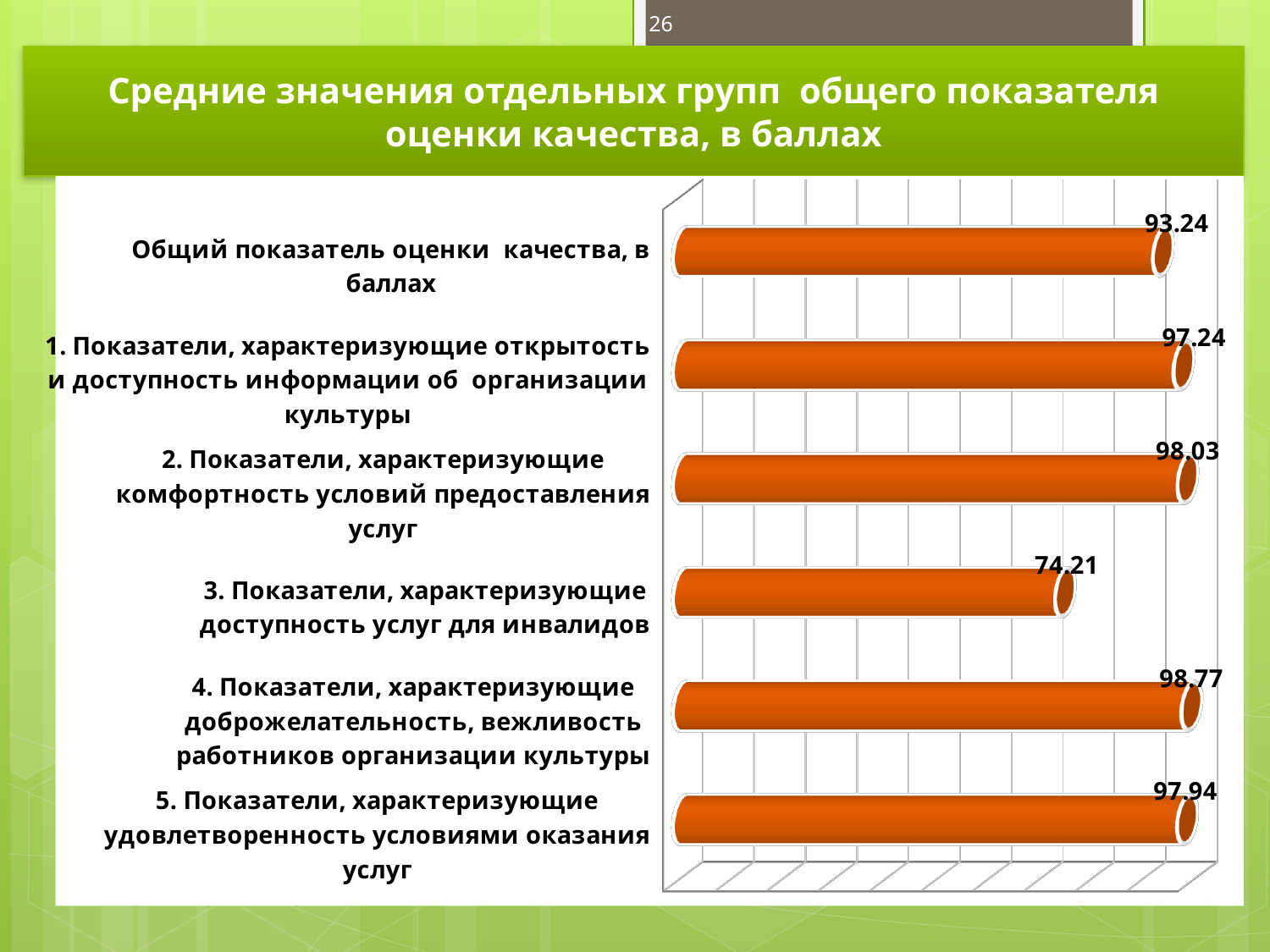
How many categories are shown in the chart? 6 What is the value for "2. Показатели, характеризующие комфортность условий предоставления услуг"? 98.03 What is the value for "4. Показатели, характеризующие доброжелательность, вежливость работников организации культуры"? 98.77 What is the difference between the values for "1. Показатели, характеризующие открытость и доступность информации об организации культуры" and "Общий показатель оценки качества, в баллах"? 4.00 What is the value for "3. Показатели, характеризующие доступность услуг для инвалидов"? 74.21 What kind of chart is shown on the slide? Bar chart What is the difference between the values for "4. Показатели, характеризующие доброжелательность, вежливость работников организации культуры" and "3. Показатели, характеризующие доступность услуг для инвалидов"? 24.56 What is the value for "Общий показатель оценки качества, в баллах"? 93.24 What is the title of the slide containing the chart? Средние значения отдельных групп общего показателя оценки качества, в баллах Which category has the lowest value? 3. Показатели, характеризующие доступность услуг для инвалидов Which category has the highest value? 4. Показатели, характеризующие доброжелательность, вежливость работников организации культуры Which is larger: the value for "5. Показатели, характеризующие удовлетворенность условиями оказания услуг" or for "Общий показатель оценки качества, в баллах"? 5. Показатели, характеризующие удовлетворенность условиями оказания услуг